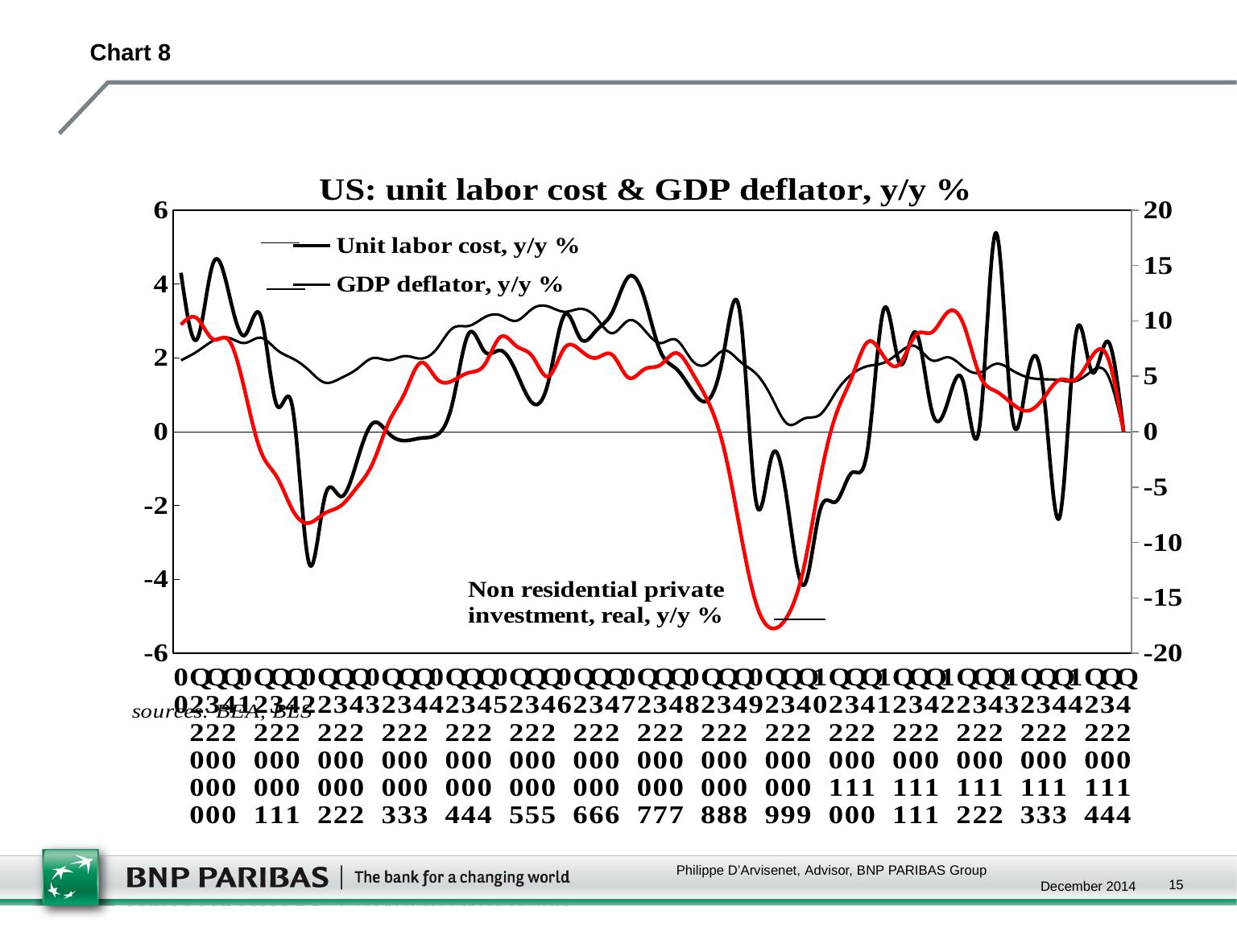
How many series does the legend at the top of the chart list? 2 Which series reaches a lower minimum on the left axis, Unit labor cost or GDP deflator? Unit labor cost After the red line reaches its lowest point, does it rise or fall over the following quarters? rise Is the lowest point of the thick black Unit labor cost line greater or less than -2 on the left axis? less Is the lowest point of the red Non residential private investment line greater or less than -15 on the right axis? less What is the lowest value shown on the right vertical axis? -20 Is the highest peak of the thick black Unit labor cost line greater or less than 4 on the left axis? greater What kind of chart is shown on the slide? line chart Which series is drawn in red on the chart? Non residential private investment, real, y/y % What is the highest value shown on the left vertical axis? 6 What is the title of the chart? US: unit labor cost & GDP deflator, y/y %